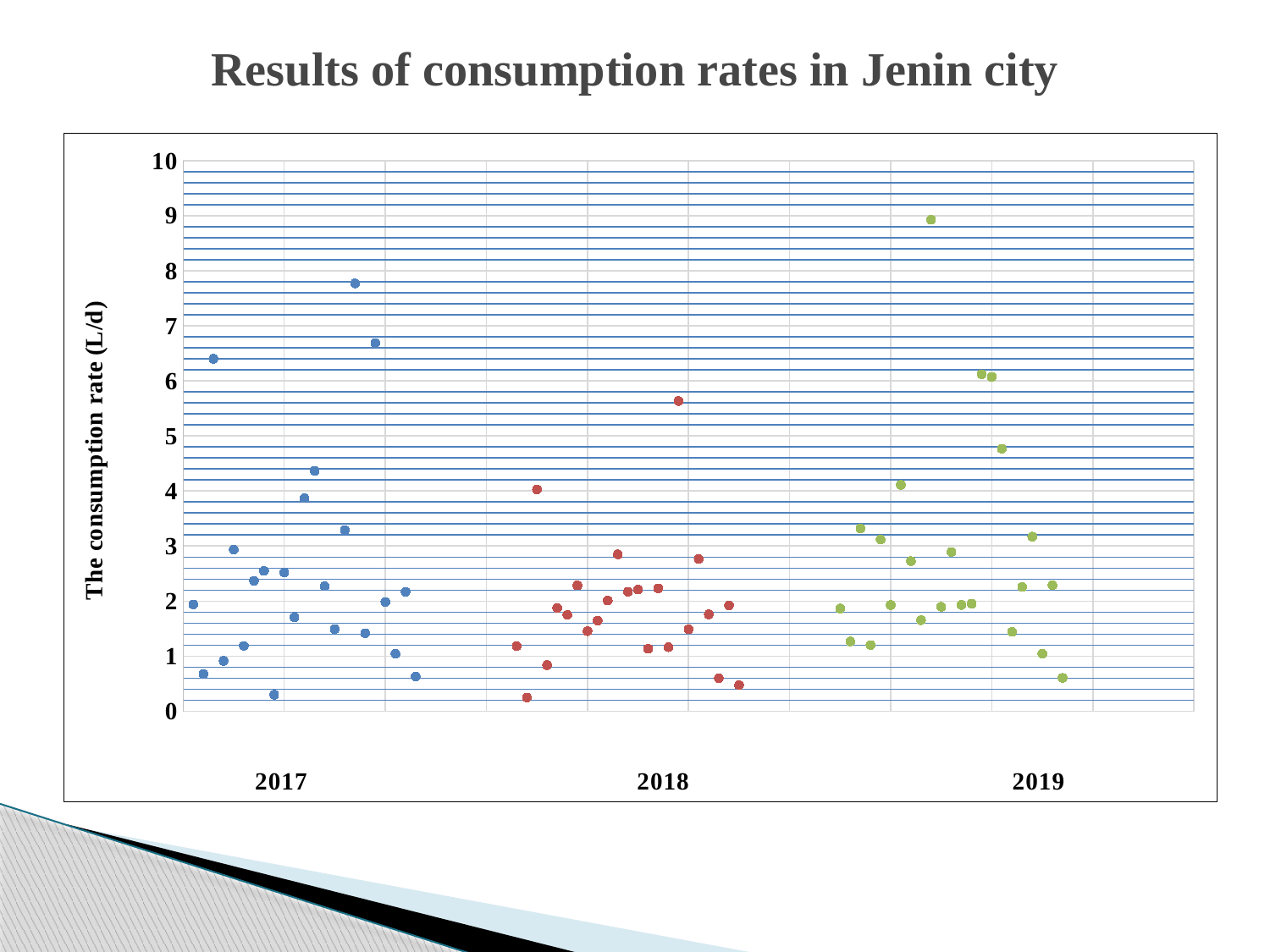
Is the highest point for 2019 greater or less than 8? greater What is the title of the chart? Results of consumption rates in Jenin city What is the label of the y axis? The consumption rate (L/d) Is the highest point for 2018 greater or less than 6? less What is the maximum value shown on the y axis? 10 Which year has the lower maximum point, 2017 or 2018? 2018 Which years are labelled along the x axis of the chart? 2017, 2018, 2019 Is the highest point for 2018 greater or less than 5? greater Which year contains the single highest consumption rate point on the chart? 2019 What kind of chart is shown on the slide? scatter chart How many years are labelled along the x axis of the chart? 3